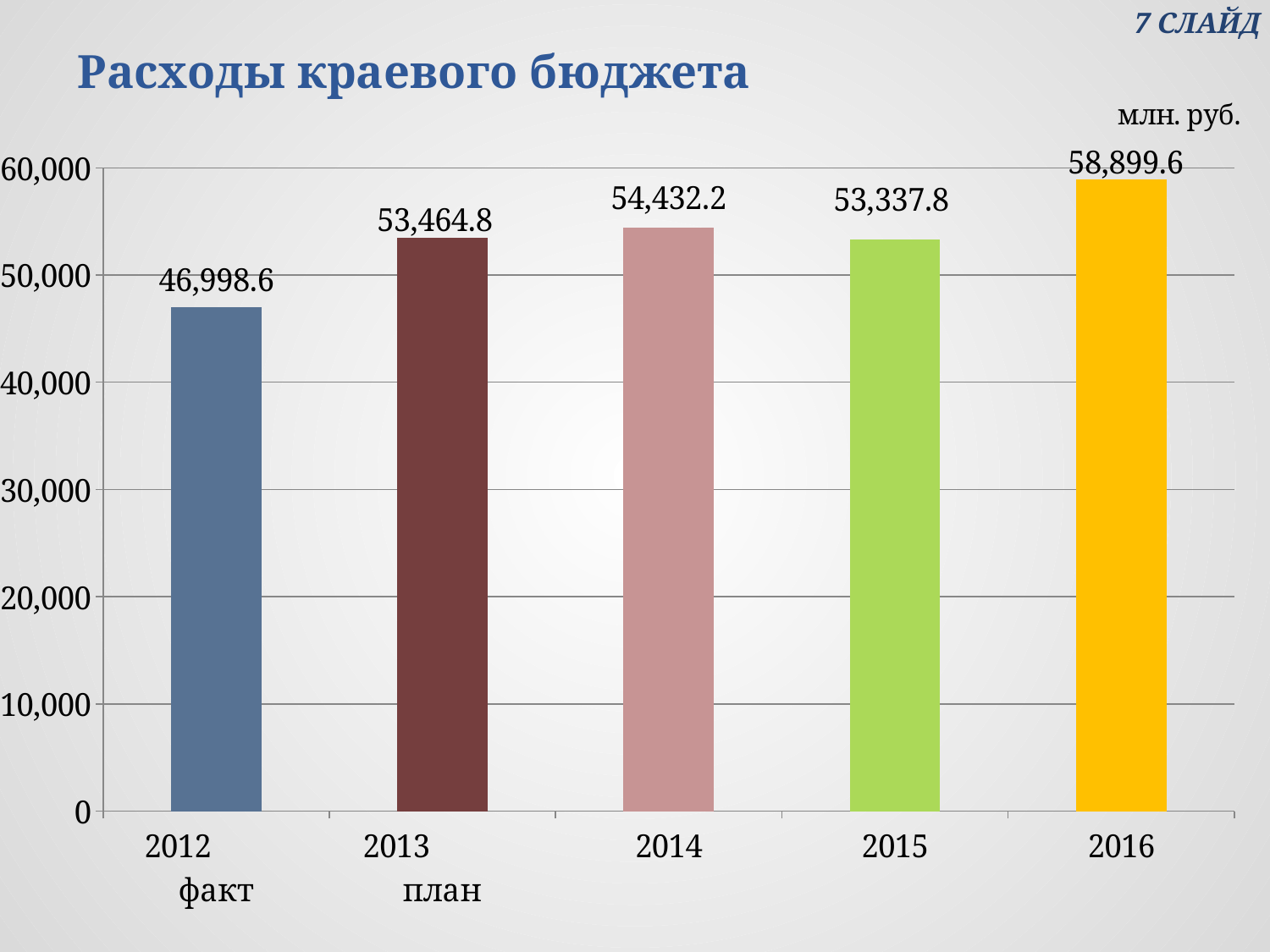
What kind of chart is shown on the slide? bar chart Which is larger, the value for 2013 or the value for 2015? 2013 What is the value for 2012 in the chart 'Расходы краевого бюджета'? 46,998.6 How many years are shown in the chart? 5 What is the value for 2014 in the chart? 54,432.2 Is the value for 2012 greater or less than 50,000? less What unit is indicated for the values in the chart? млн. руб. What is the difference between the values for 2014 and 2015? 1,094.4 Which year has the highest value in the chart? 2016 What is the difference between the values for 2016 and 2012? 11,901.0 Which year has the lowest value in the chart? 2012 What is the value for 2016 in the chart? 58,899.6